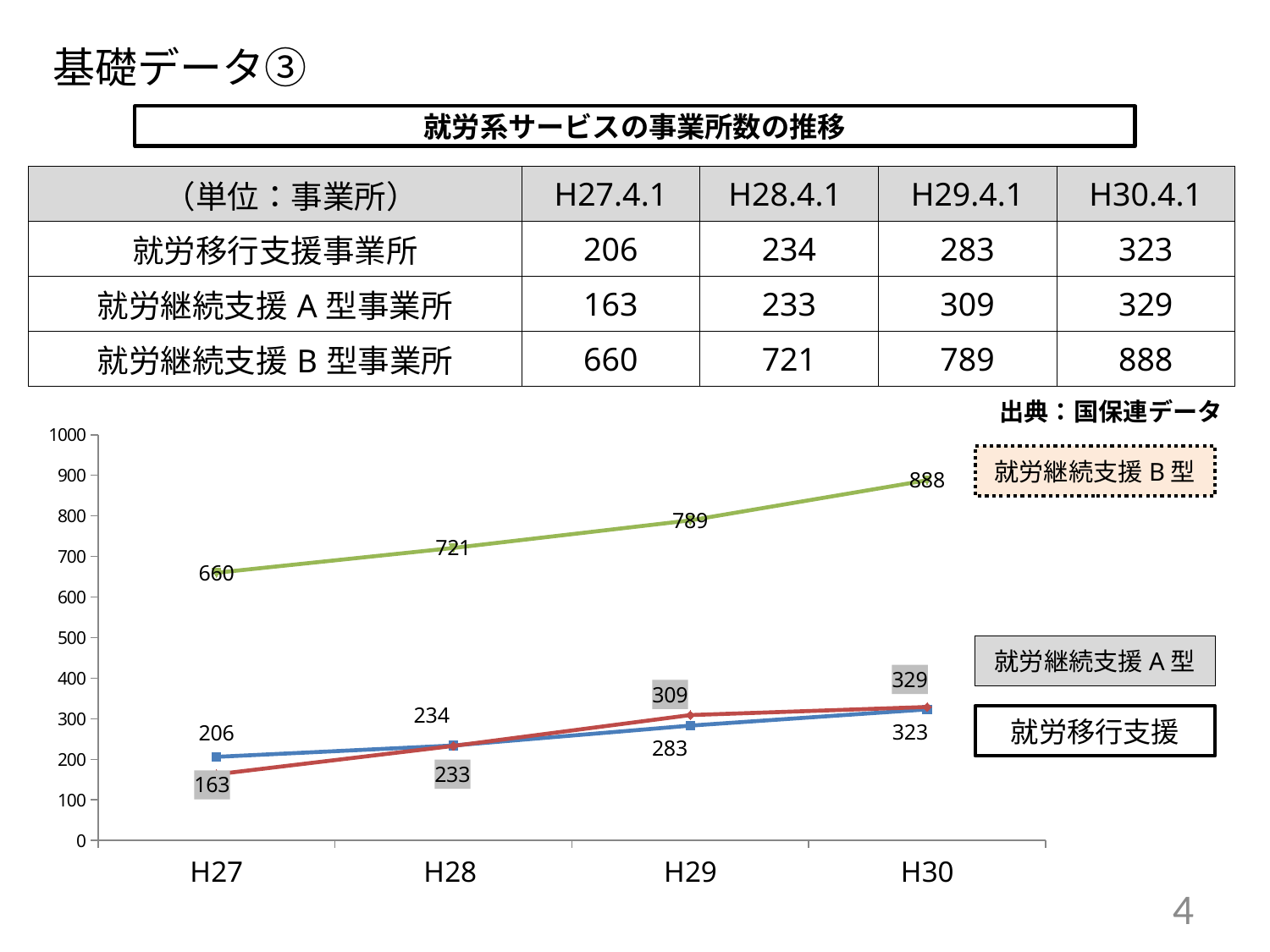
What is the difference between the 就労継続支援B型 values at H30 and H27? 228 What is the value for 就労移行支援 at H29? 283 What is the value for 就労継続支援A型 at H27? 163 Does the 就労継続支援B型 series rise or fall from H27 to H30? rise How many points are plotted along the x axis of the chart? 4 At which x-axis point is the 就労継続支援B型 series highest? H30 At which x-axis point is the 就労継続支援A型 series lowest? H27 What kind of chart is shown on the slide? line chart What is the value for 就労継続支援B型 at H30? 888 Which series is drawn with the green line? 就労継続支援B型 Which is larger at H27: 就労移行支援 or 就労継続支援A型? 就労移行支援 How many series are plotted in the chart? 3